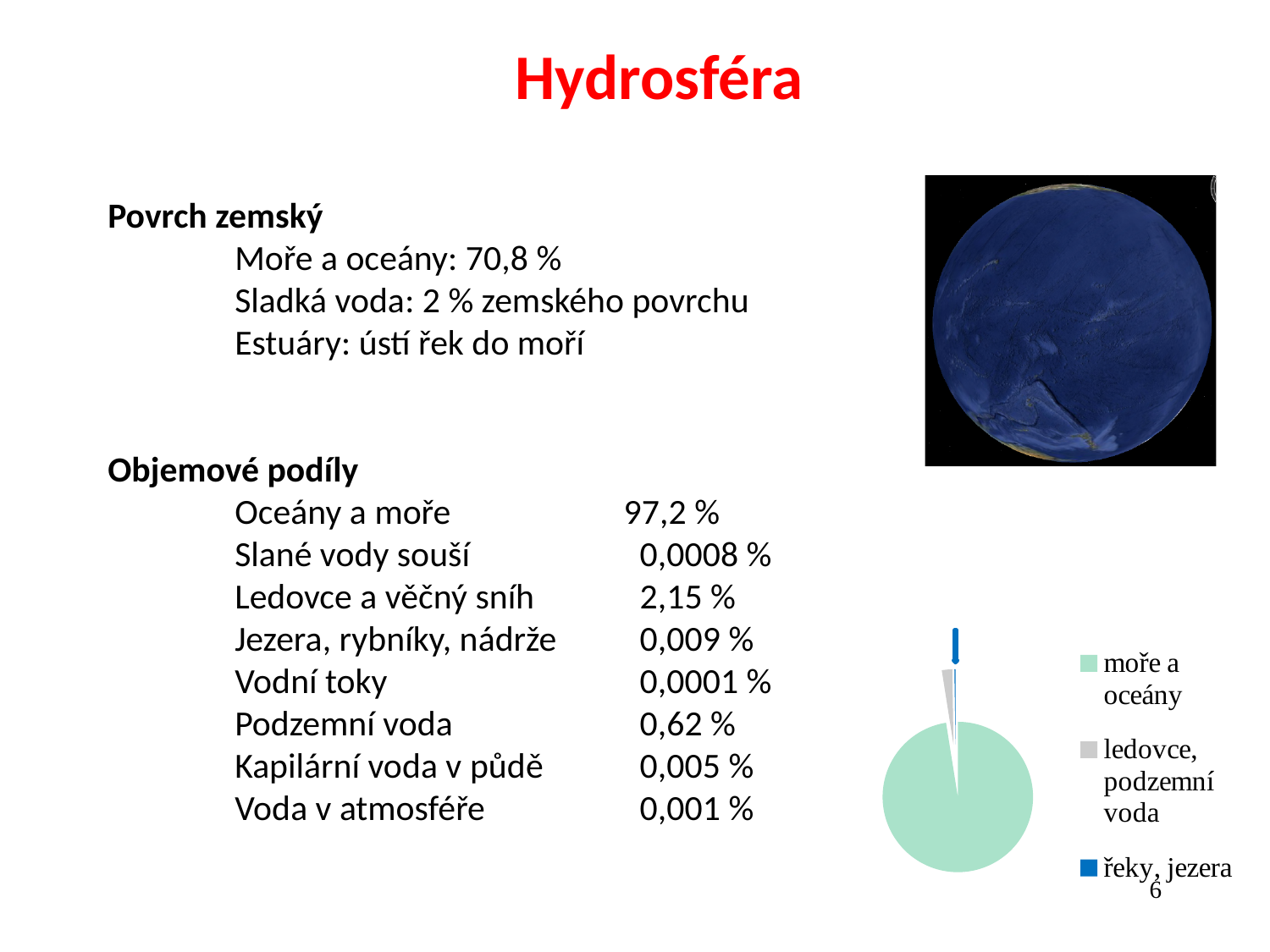
What colour represents moře a oceány in the pie chart? light green What kind of chart is shown at the bottom right of the slide? pie chart Which category takes up the largest share of the pie chart? moře a oceány In the pie chart, which is larger: moře a oceány or ledovce, podzemní voda? moře a oceány Which legend entry of the pie chart is shown in blue? řeky, jezera Which category takes up the smallest share of the pie chart? řeky, jezera In the pie chart, which is larger: ledovce, podzemní voda or řeky, jezera? ledovce, podzemní voda How many slices does the pie chart have? 3 How many entries does the legend of the pie chart list? 3